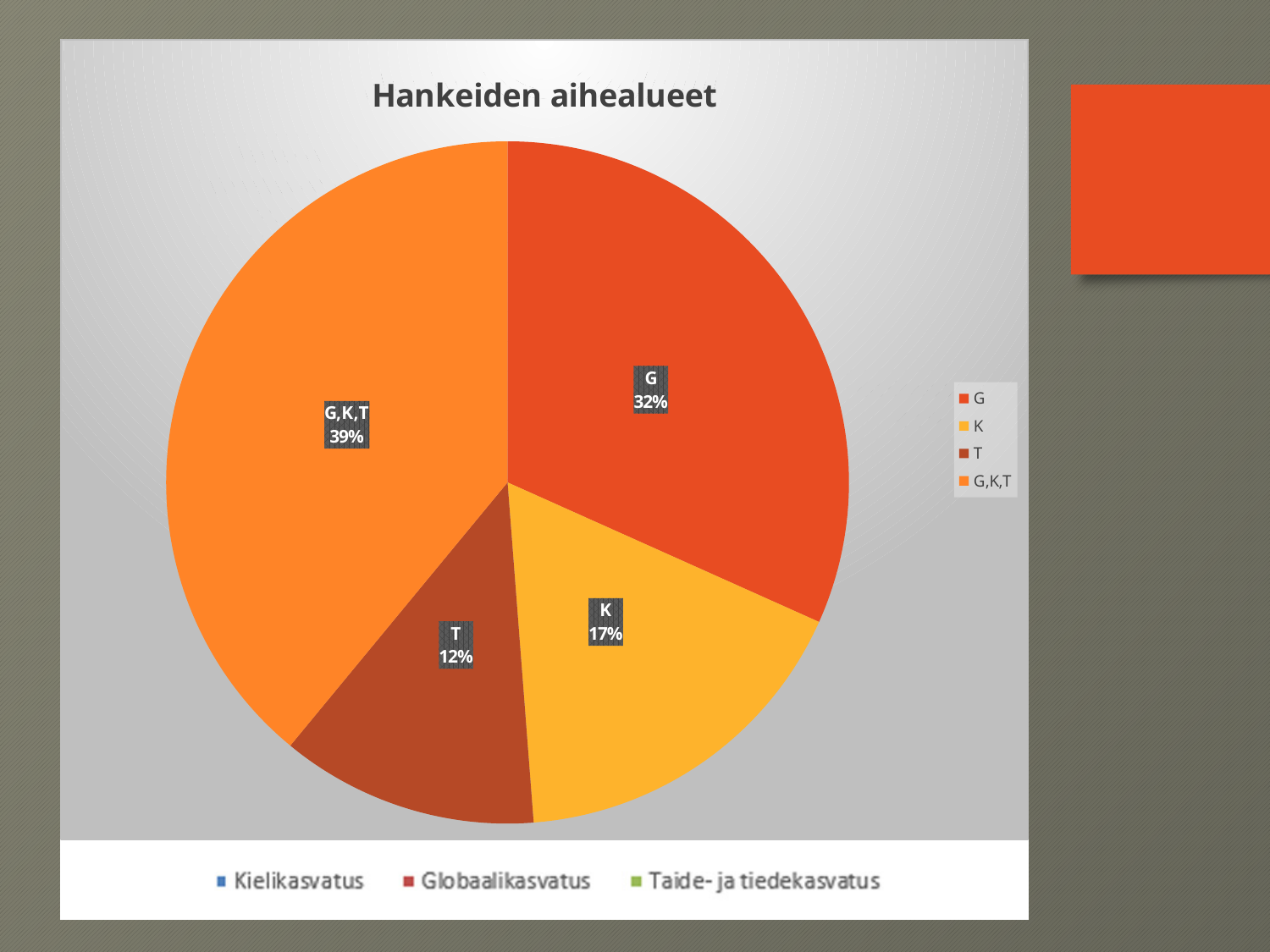
What percentage does the G,K,T slice represent? 39% What percentage does the K slice represent? 17% How many slices does the pie chart have? 4 Which is larger, the K slice or the T slice? K What kind of chart is shown on the slide? pie chart What is the title of the chart? Hankeiden aihealueet What is the difference in percentage points between the G,K,T slice and the G slice? 7 What percentage does the G slice represent? 32% How many entries does the legend on the right of the pie list? 4 Which slice is the smallest? T Which slice is the largest? G,K,T What percentage does the T slice represent? 12%